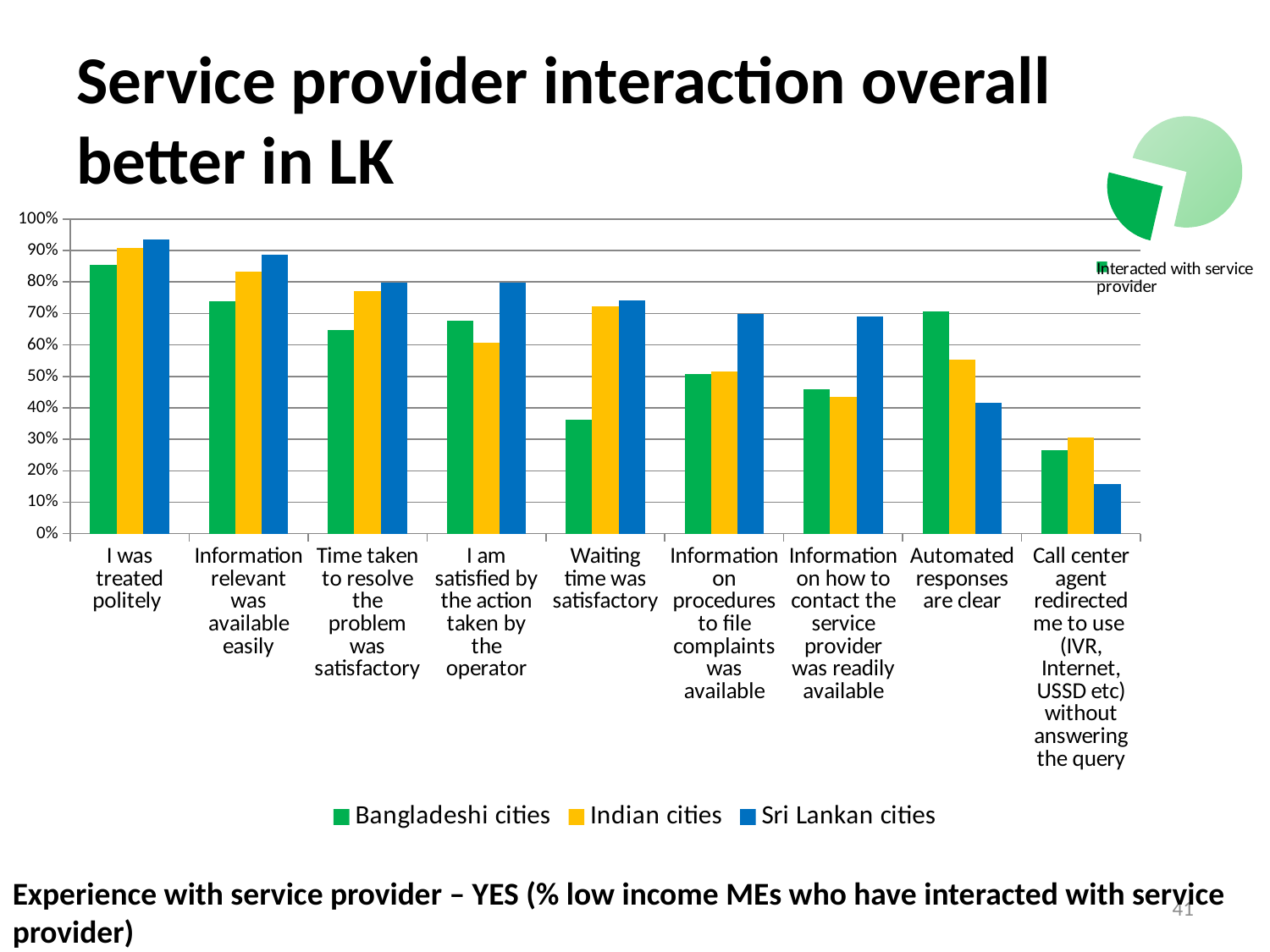
In the bar chart, for 'Waiting time was satisfactory', which is larger: Bangladeshi cities or Indian cities? Indian cities In the bar chart, is the value for Sri Lankan cities for 'Call center agent redirected me to use (IVR, Internet, USSD etc) without answering the query' greater or less than 20%? less In the bar chart, which series has the highest value for 'Information on how to contact the service provider was readily available'? Sri Lankan cities In the bar chart, how many statement categories are shown along the x axis? 9 In the bar chart, what kind of chart is used to show the experience with service provider data? Bar chart In the bar chart, which category has the highest value for Sri Lankan cities? I was treated politely In the bar chart, for 'Automated responses are clear', which is larger: Bangladeshi cities or Sri Lankan cities? Bangladeshi cities In the bar chart, what colour represents Indian cities in the legend? Yellow In the bar chart, which category has the lowest value for Sri Lankan cities? Call center agent redirected me to use (IVR, Internet, USSD etc) without answering the query In the bar chart, is the value for Sri Lankan cities for 'I was treated politely' greater or less than 90%? greater In the bar chart, how many series does the legend list? 3 In the bar chart, is the value for Bangladeshi cities for 'Waiting time was satisfactory' greater or less than 40%? less